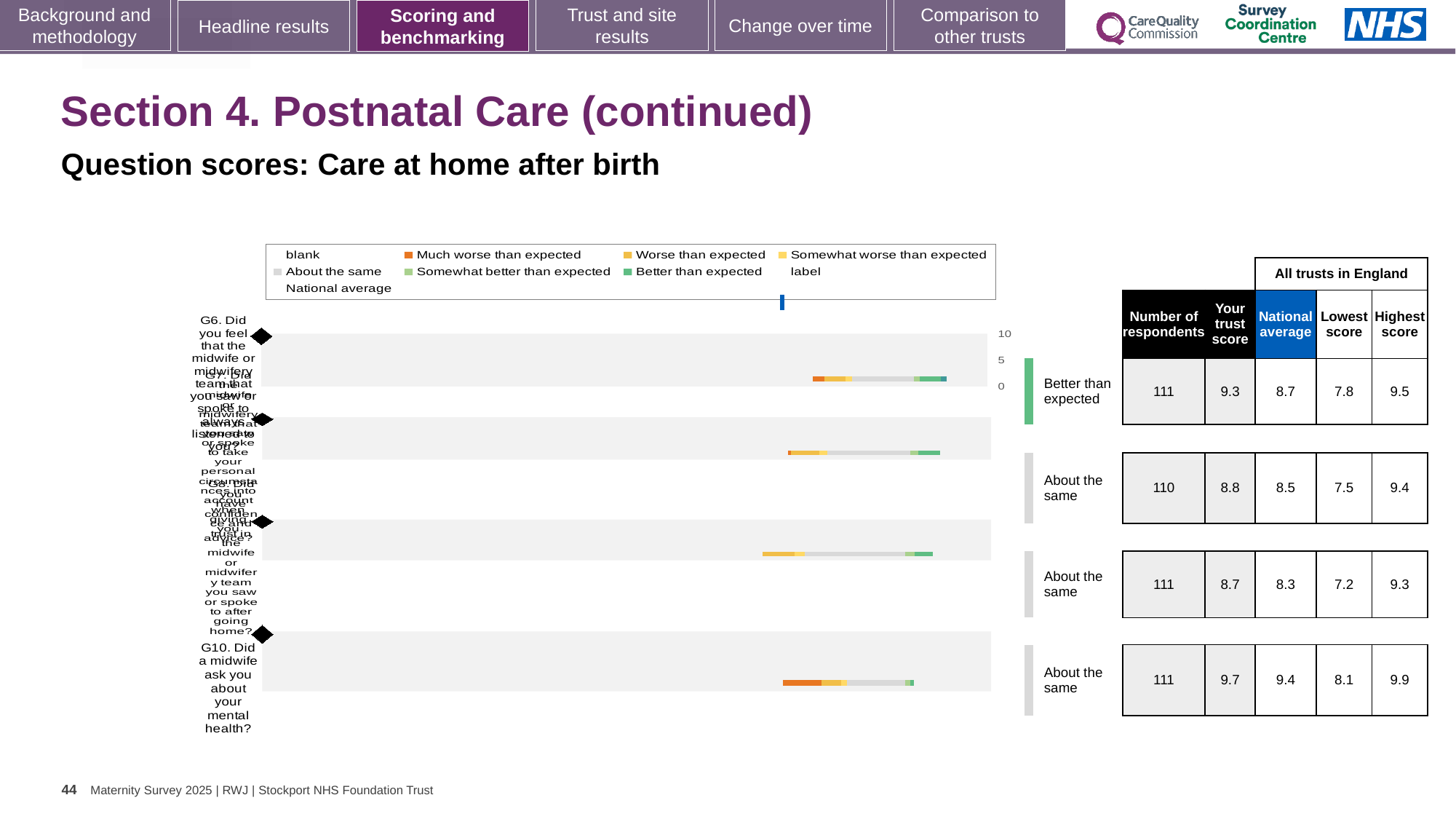
What is the 'Your trust score' for G10 (Did a midwife ask you about your mental health?)? 9.7 What is the 'Your trust score' for G6, the first question in the chart? 9.3 What is the highest score across all trusts in England for G6, the first question in the chart? 9.5 For G6, which is larger: the trust score or the national average? the trust score How many question bars are plotted in the chart? 4 In the chart legend, what colour represents 'Much worse than expected'? orange What is the national average for G10 (Did a midwife ask you about your mental health?)? 9.4 Which question in the chart has the highest 'Your trust score'? G10 What kind of chart is shown on the slide? bar chart How many respondents answered G10 (Did a midwife ask you about your mental health?)? 111 In the chart legend, what colour represents 'Better than expected'? green What is the difference between the trust score and the national average for G10? 0.3